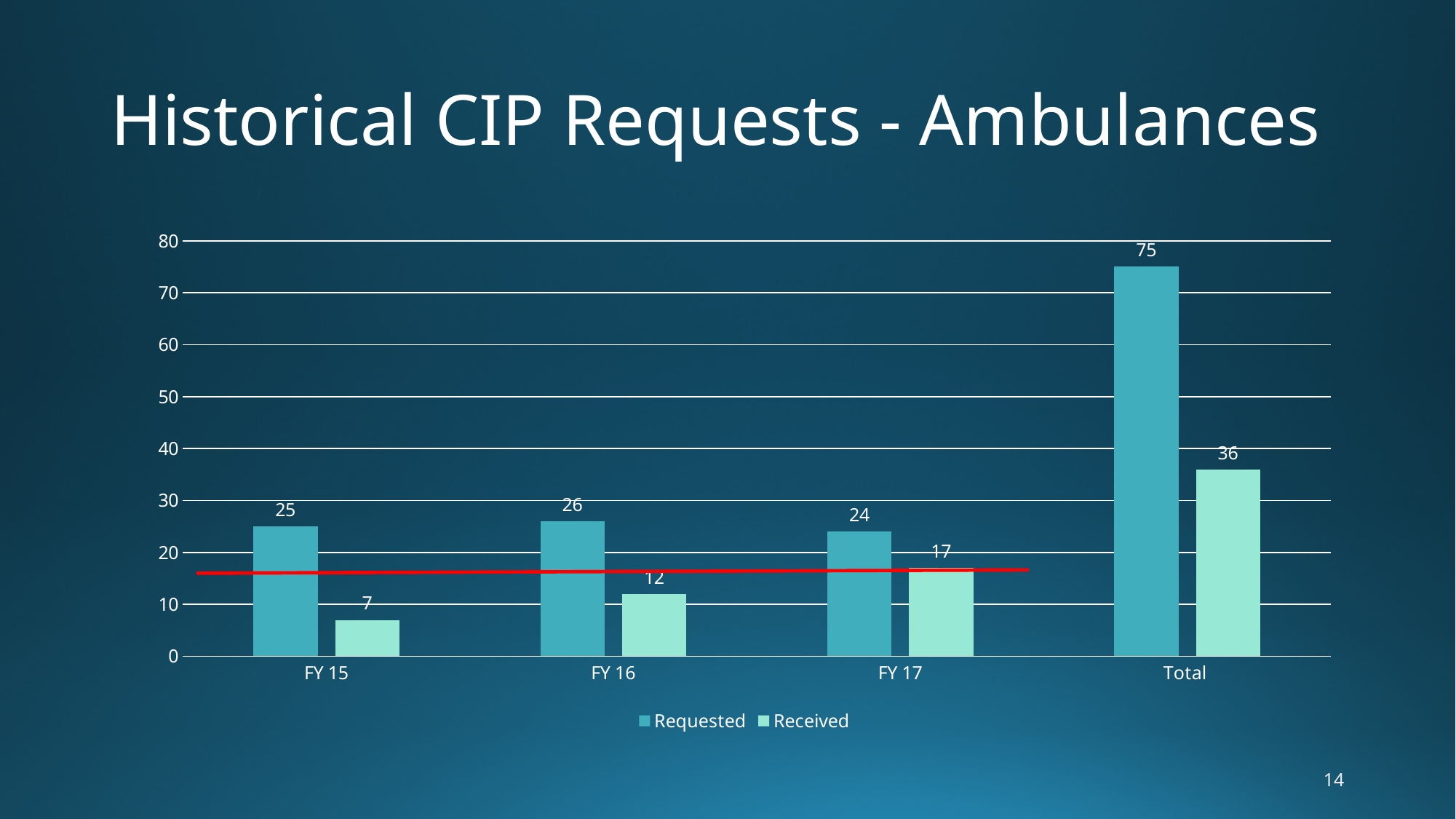
Among FY 15, FY 16 and FY 17, which has the highest Requested value? FY 16 How many series does the legend list? 2 What is the Requested value for FY 15? 25 Which is larger for FY 16, Requested or Received? Requested Which category has the lowest Received value? FY 15 What is the difference between the Total Requested and Total Received values? 39 What is the difference between Requested and Received for FY 17? 7 What kind of chart is shown on the slide? Bar chart What is the Received value for FY 16? 12 What is the Requested value for Total? 75 What is the Received value for FY 17? 17 How many categories are shown on the x axis? 4